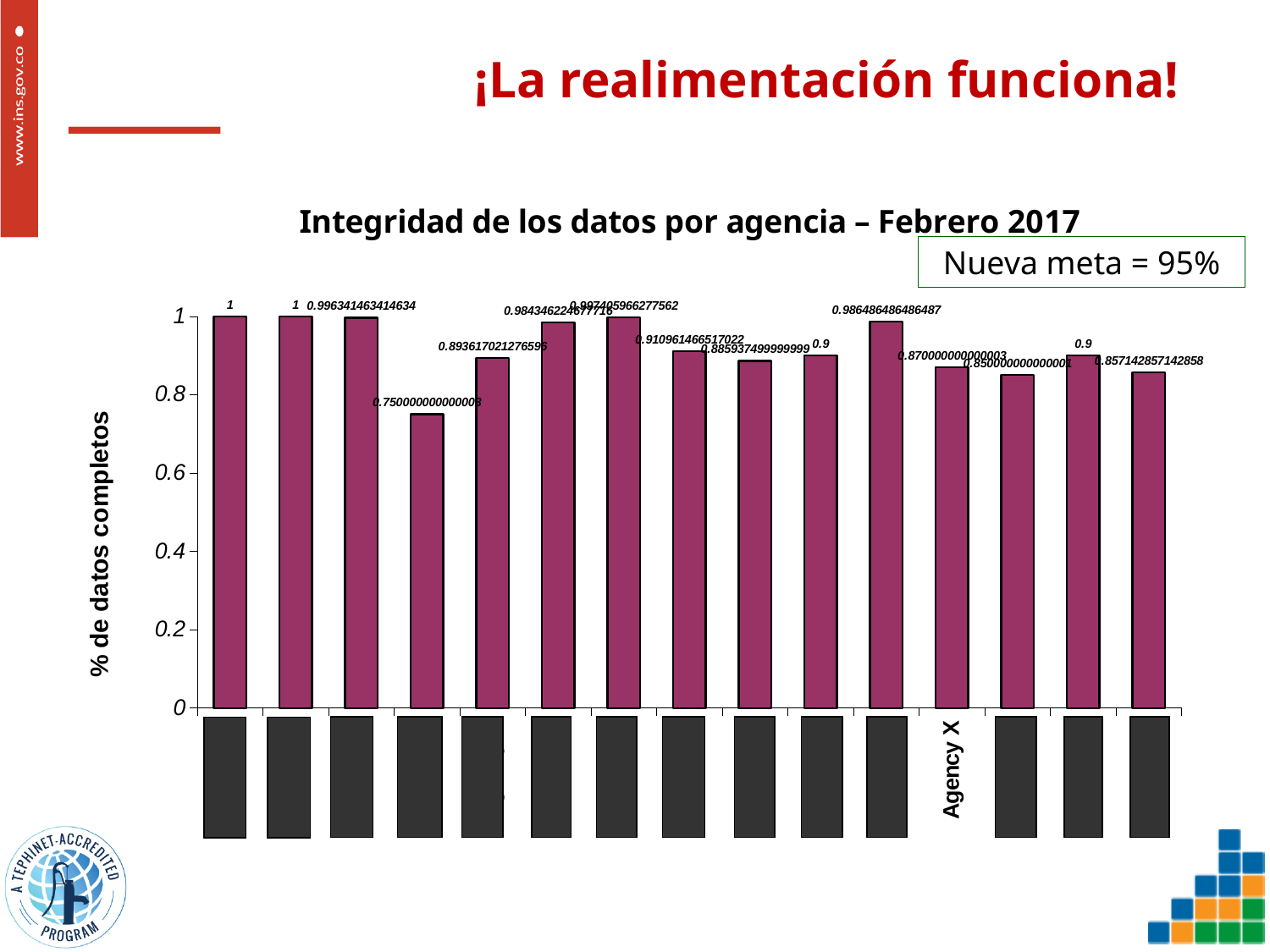
What is the highest value labelled on any bar in the chart? 1 Is the value for Agency X greater or less than 0.8? greater What kind of chart is shown on the slide? bar chart What new target (nueva meta) is stated on the slide? 95% Is the value for Agency X greater or less than the first bar's value of 1? less What is the value shown for Agency X? 0.870000000000003 What is the title of the chart? Integridad de los datos por agencia – Febrero 2017 What is the lowest value labelled on any bar in the chart? 0.750000000000003 How many bars are plotted in the chart? 15 How many bars have a labelled value of exactly 1? 2 How many bars have a labelled value of 0.95 or higher? 6 What is the label of the y axis? % de datos completos